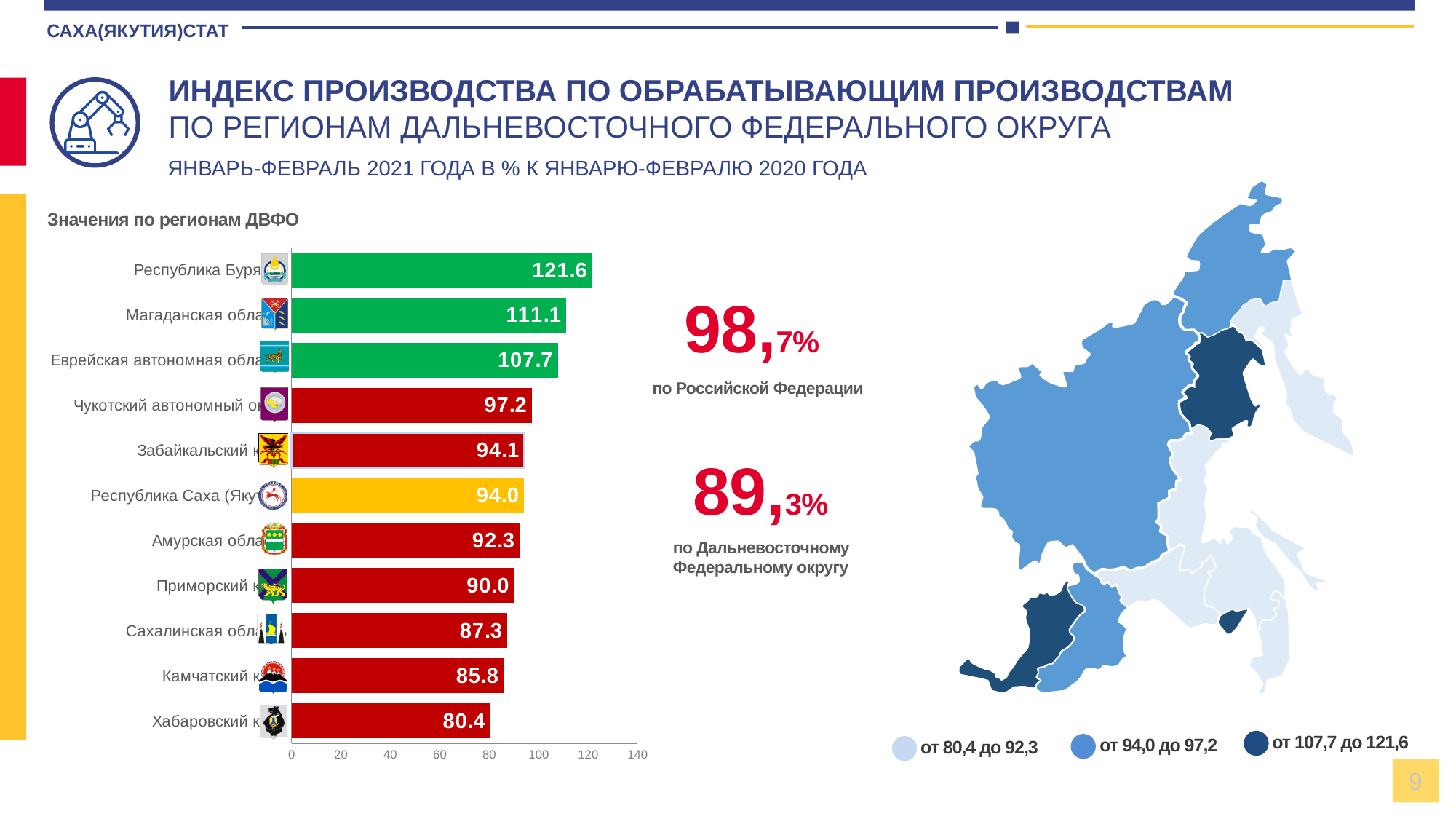
Which region has the highest value? Республика Бурятия What is the value for Республика Саха (Якутия)? 94.0 Which is larger, the value for Амурская область or the value for Сахалинская область? Амурская область What is the value for Республика Бурятия? 121.6 What is the difference between the values for Республика Бурятия and Хабаровский край? 41.2 What kind of chart is shown on the slide? bar chart What is the value for Хабаровский край? 80.4 Is the value for Еврейская автономная область greater or less than 100? greater What is the value for Магаданская область? 111.1 How many regions are shown in the bar chart? 11 What colour is the bar for Республика Саха (Якутия)? yellow Which region has the lowest value? Хабаровский край